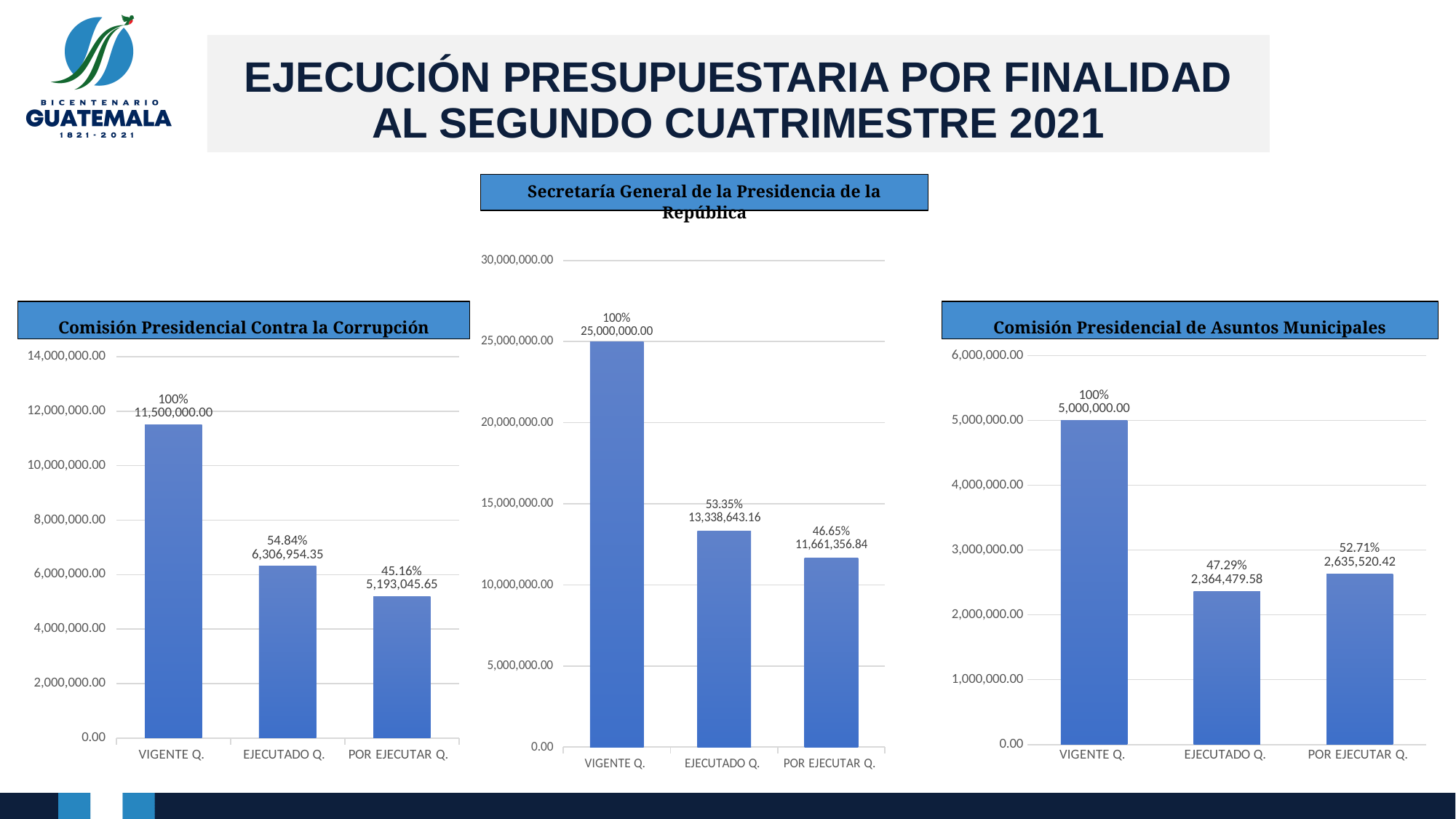
In the 'Secretaría General de la Presidencia de la República' chart, what is the value for VIGENTE Q.? 25,000,000.00 What type of chart is the 'Comisión Presidencial de Asuntos Municipales' chart? Bar chart In the 'Comisión Presidencial de Asuntos Municipales' chart, what is the value for POR EJECUTAR Q.? 2,635,520.42 How many categories are shown in the 'Secretaría General de la Presidencia de la República' chart? 3 In the 'Comisión Presidencial Contra la Corrupción' chart, what is the difference between EJECUTADO Q. and POR EJECUTAR Q.? 1,113,908.70 In the 'Comisión Presidencial de Asuntos Municipales' chart, which category has the lowest value? EJECUTADO Q. In the 'Secretaría General de la Presidencia de la República' chart, what is the difference between EJECUTADO Q. and POR EJECUTAR Q.? 1,677,286.32 In the 'Comisión Presidencial de Asuntos Municipales' chart, which is larger, EJECUTADO Q. or POR EJECUTAR Q.? POR EJECUTAR Q. In the 'Comisión Presidencial Contra la Corrupción' chart, which category has the highest value? VIGENTE Q. In the 'Comisión Presidencial Contra la Corrupción' chart, what percentage is shown above the POR EJECUTAR Q. bar? 45.16% In the 'Comisión Presidencial Contra la Corrupción' chart, what is the value for EJECUTADO Q.? 6,306,954.35 In the 'Secretaría General de la Presidencia de la República' chart, what percentage is shown for EJECUTADO Q.? 53.35%